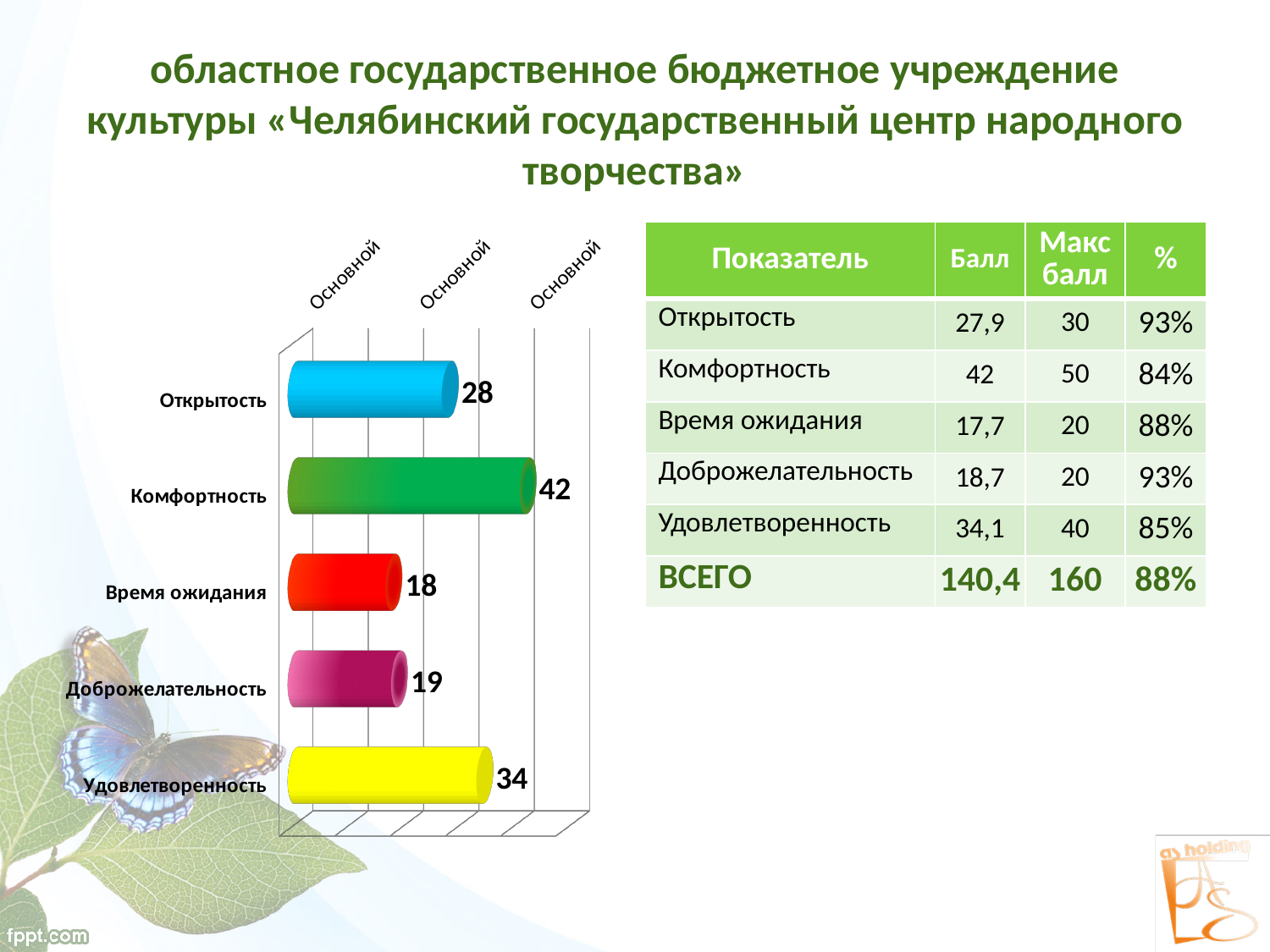
What colour is the bar for Время ожидания in the chart? Red What is the value shown for Доброжелательность in the bar chart? 19 What is the difference between the values for Удовлетворенность and Время ожидания in the bar chart? 16 How many categories are shown in the bar chart? 5 Which has a larger value in the bar chart, Открытость or Удовлетворенность? Удовлетворенность What kind of chart is shown on the slide? Bar chart What is the value shown for Комфортность in the bar chart? 42 What is the value shown for Открытость in the bar chart? 28 What is the difference between the values for Комфортность and Открытость in the bar chart? 14 Which category has the lowest value in the bar chart? Время ожидания What is the value shown for Удовлетворенность in the bar chart? 34 Which category has the highest value in the bar chart? Комфортность